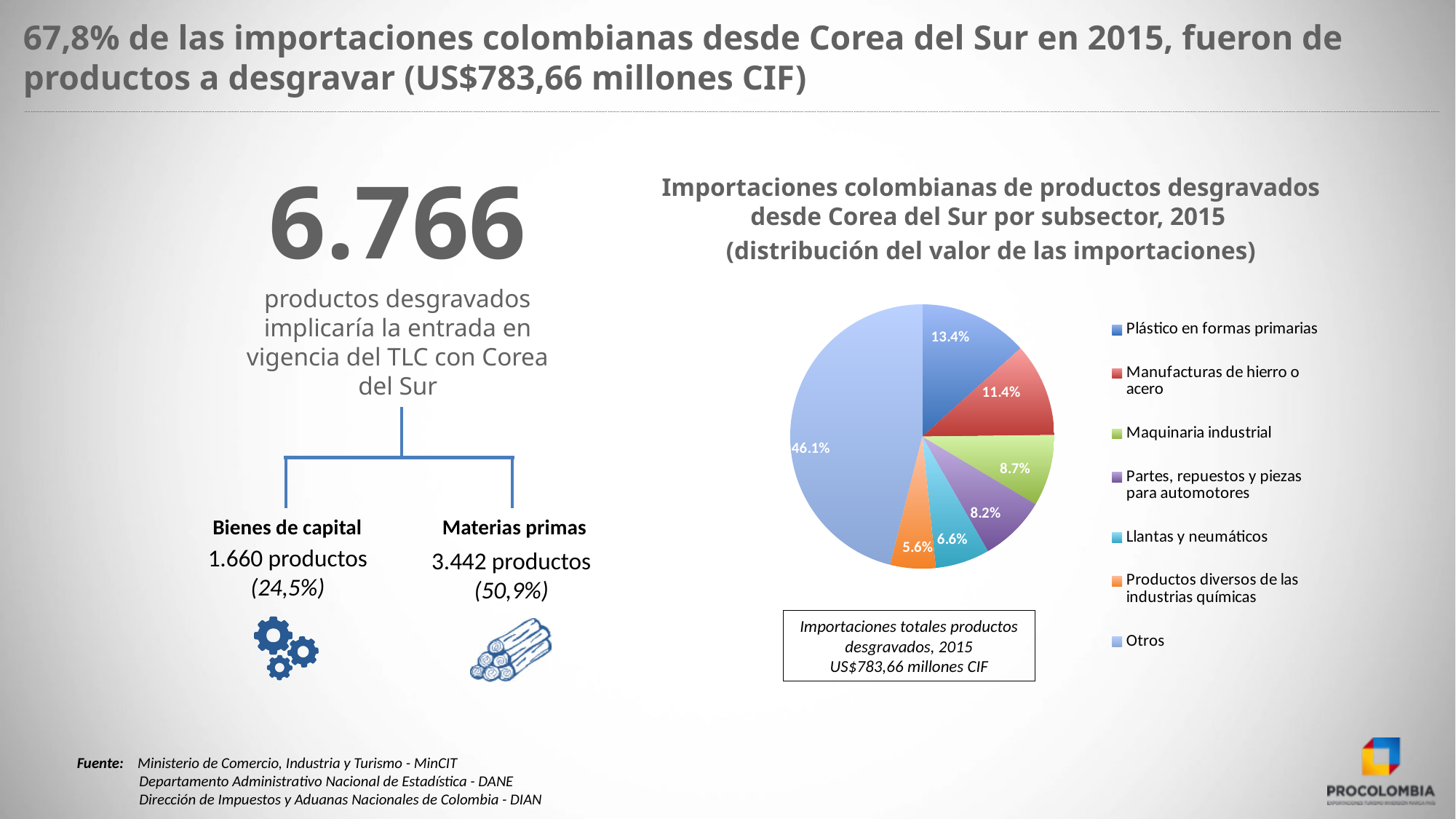
What share of the pie does Manufacturas de hierro o acero have? 11.4% What share of the pie does Llantas y neumáticos have? 6.6% What share of the pie does Productos diversos de las industrias químicas have? 5.6% Which is larger, the share for Partes, repuestos y piezas para automotores or the share for Llantas y neumáticos? Partes, repuestos y piezas para automotores What share of the pie does Plástico en formas primarias have? 13.4% What share of the pie does Maquinaria industrial have? 8.7% Which category has the largest slice of the pie? Otros What kind of chart is shown on the slide? pie chart How many categories does the pie chart legend list? 7 Which category has the smallest slice of the pie? Productos diversos de las industrias químicas What is the title of the pie chart? Importaciones colombianas de productos desgravados desde Corea del Sur por subsector, 2015 (distribución del valor de las importaciones) What is the difference in percentage points between Plástico en formas primarias and Manufacturas de hierro o acero? 2.0